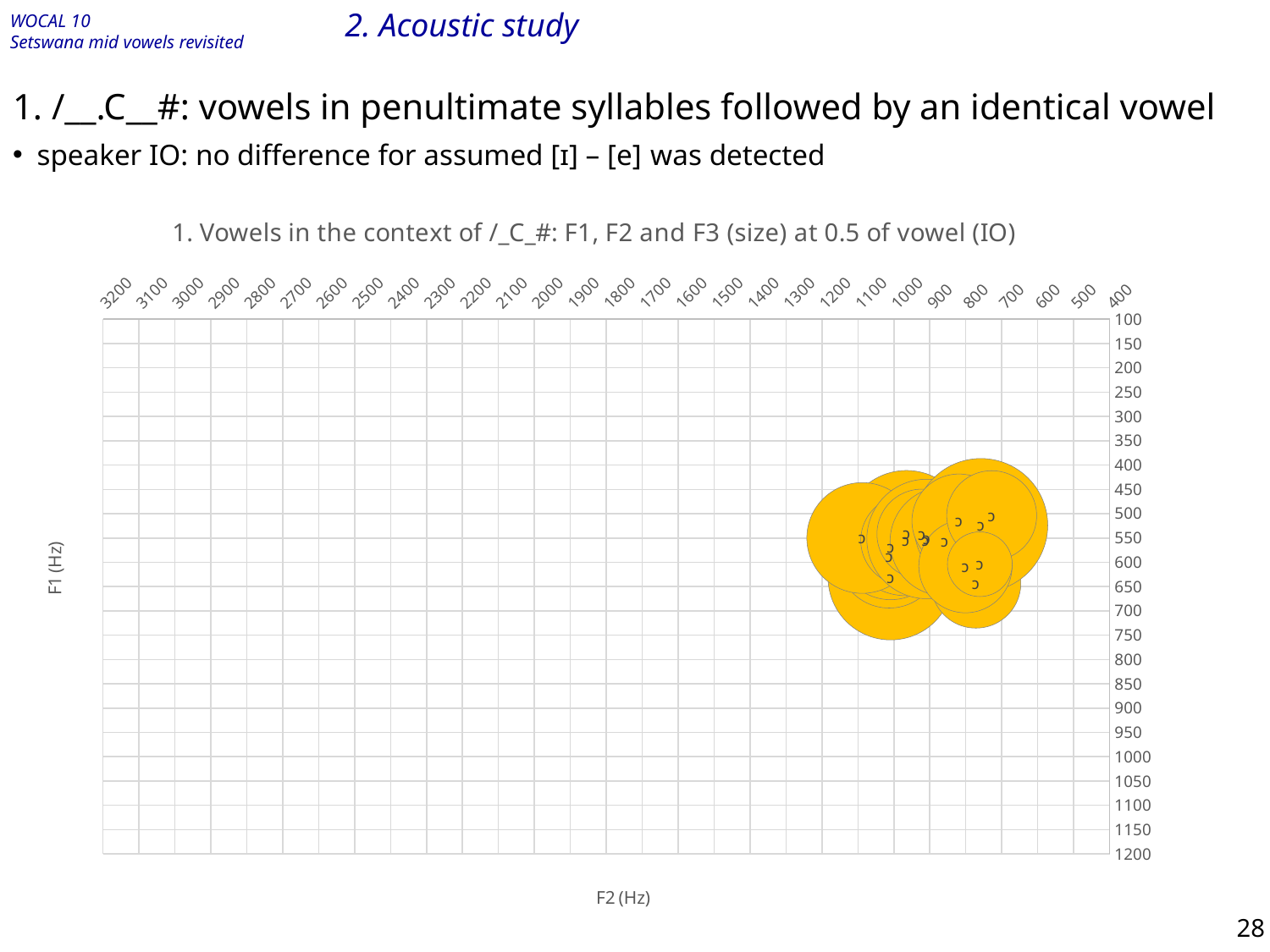
Are the F1 values of the plotted bubbles greater or less than 1000 Hz? less What is the highest value shown on the horizontal (F2) axis? 3200 What is the smallest value shown on the vertical (F1) axis? 100 Are the F2 values of the plotted bubbles greater or less than 1400 Hz? less What is the title of the chart? 1. Vowels in the context of /_C_#: F1, F2 and F3 (size) at 0.5 of vowel (IO) Are the F1 values of the plotted bubbles greater or less than 300 Hz? greater What is the label of the horizontal axis of the chart? F2 (Hz) What is the largest value shown on the vertical (F1) axis? 1200 What kind of chart is shown on the slide? bubble chart What is the label of the vertical axis of the chart? F1 (Hz) What is the lowest value shown on the horizontal (F2) axis? 400